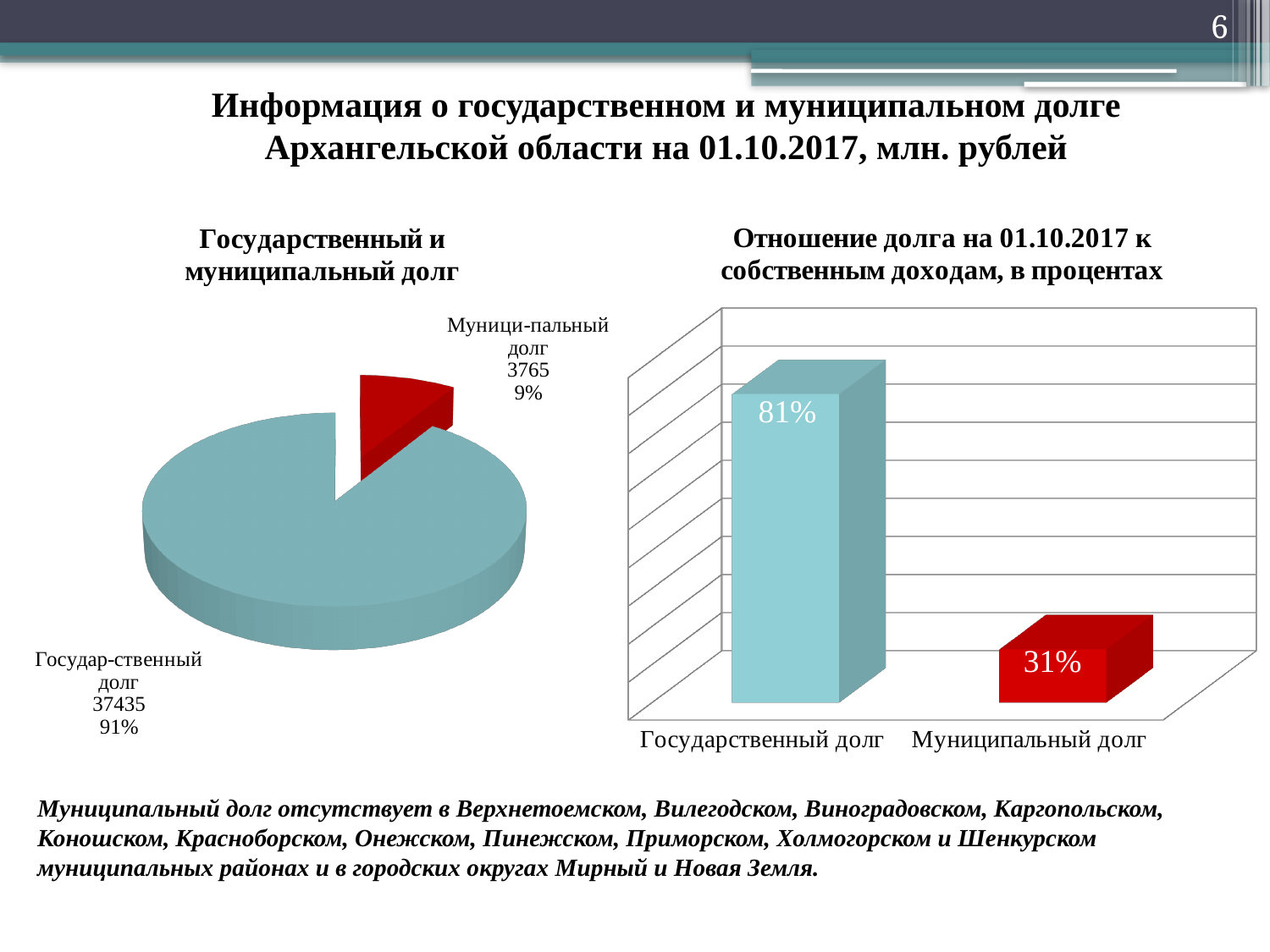
In the right chart 'Отношение долга на 01.10.2017 к собственным доходам, в процентах', what is the value for Муниципальный долг? 31% What kind of chart is the right chart 'Отношение долга на 01.10.2017 к собственным доходам, в процентах'? Bar chart In the pie chart 'Государственный и муниципальный долг', which slice is the largest? Государственный долг In the pie chart 'Государственный и муниципальный долг', what is the value for Муниципальный долг? 3765 In the right chart 'Отношение долга на 01.10.2017 к собственным доходам, в процентах', what is the value for Государственный долг? 81% In the pie chart 'Государственный и муниципальный долг', what is the difference between Государственный долг and Муниципальный долг? 33670 In the right chart 'Отношение долга на 01.10.2017 к собственным доходам, в процентах', which category has the lowest value? Муниципальный долг What kind of chart is the left chart 'Государственный и муниципальный долг'? Pie chart In the pie chart 'Государственный и муниципальный долг', what share of the pie does Государственный долг represent? 91% In the pie chart 'Государственный и муниципальный долг', what share of the pie does Муниципальный долг represent? 9% In the pie chart 'Государственный и муниципальный долг', what is the value for Государственный долг? 37435 In the pie chart 'Государственный и муниципальный долг', how many slices are there? 2